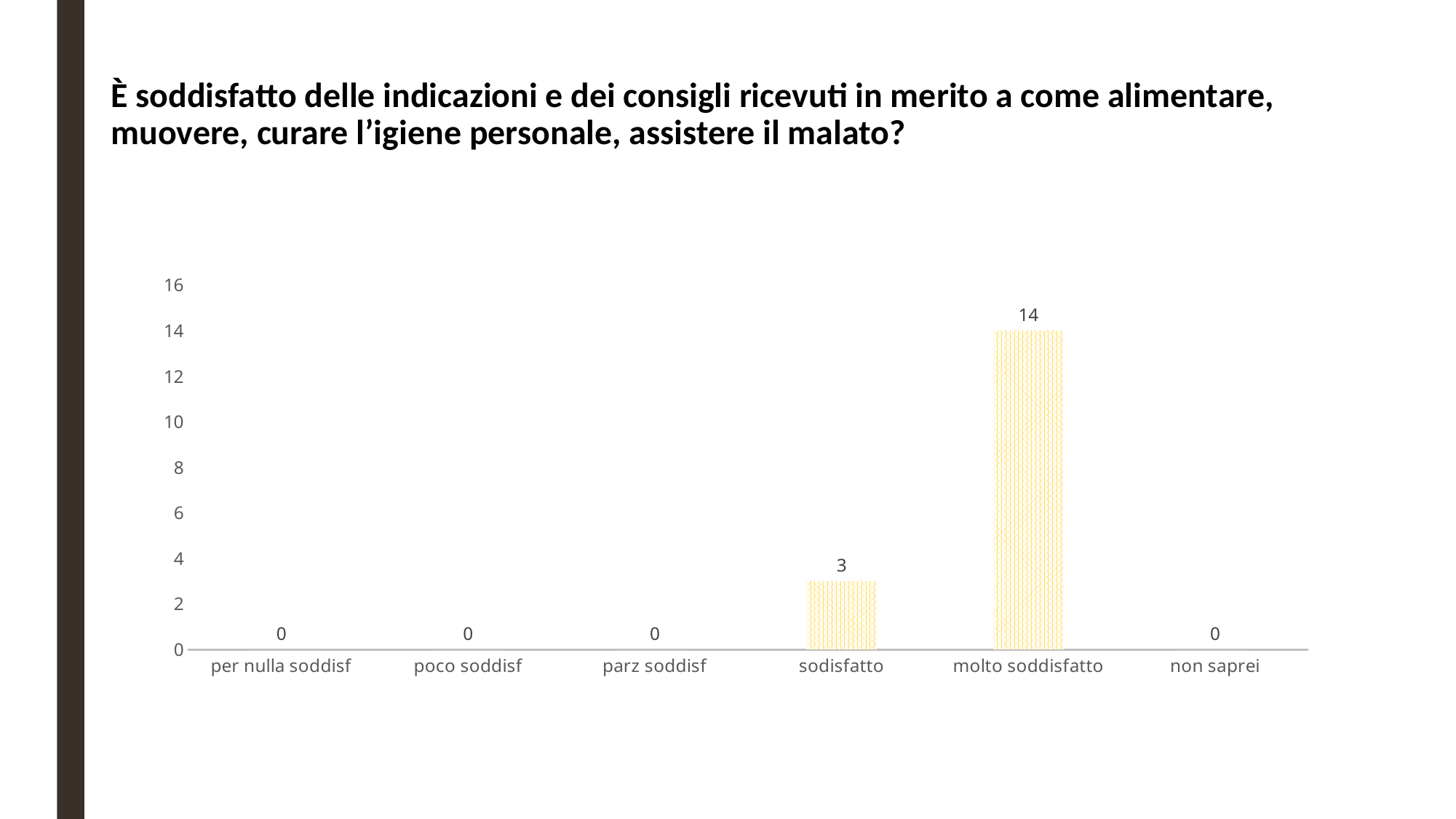
Which is larger, the value for "sodisfatto" or the value for "molto soddisfatto"? molto soddisfatto Is the value for "molto soddisfatto" greater or less than 10? greater What is the difference between the values for "molto soddisfatto" and "sodisfatto"? 11 What is the value for "poco soddisf"? 0 What is the value for "non saprei"? 0 What is the value for "sodisfatto"? 3 What is the value for "molto soddisfatto"? 14 What kind of chart is shown on the slide? bar chart Which category has the highest value? molto soddisfatto How many categories have a value of 0? 4 How many categories are shown on the x axis? 6 What is the highest value shown on the vertical axis? 16